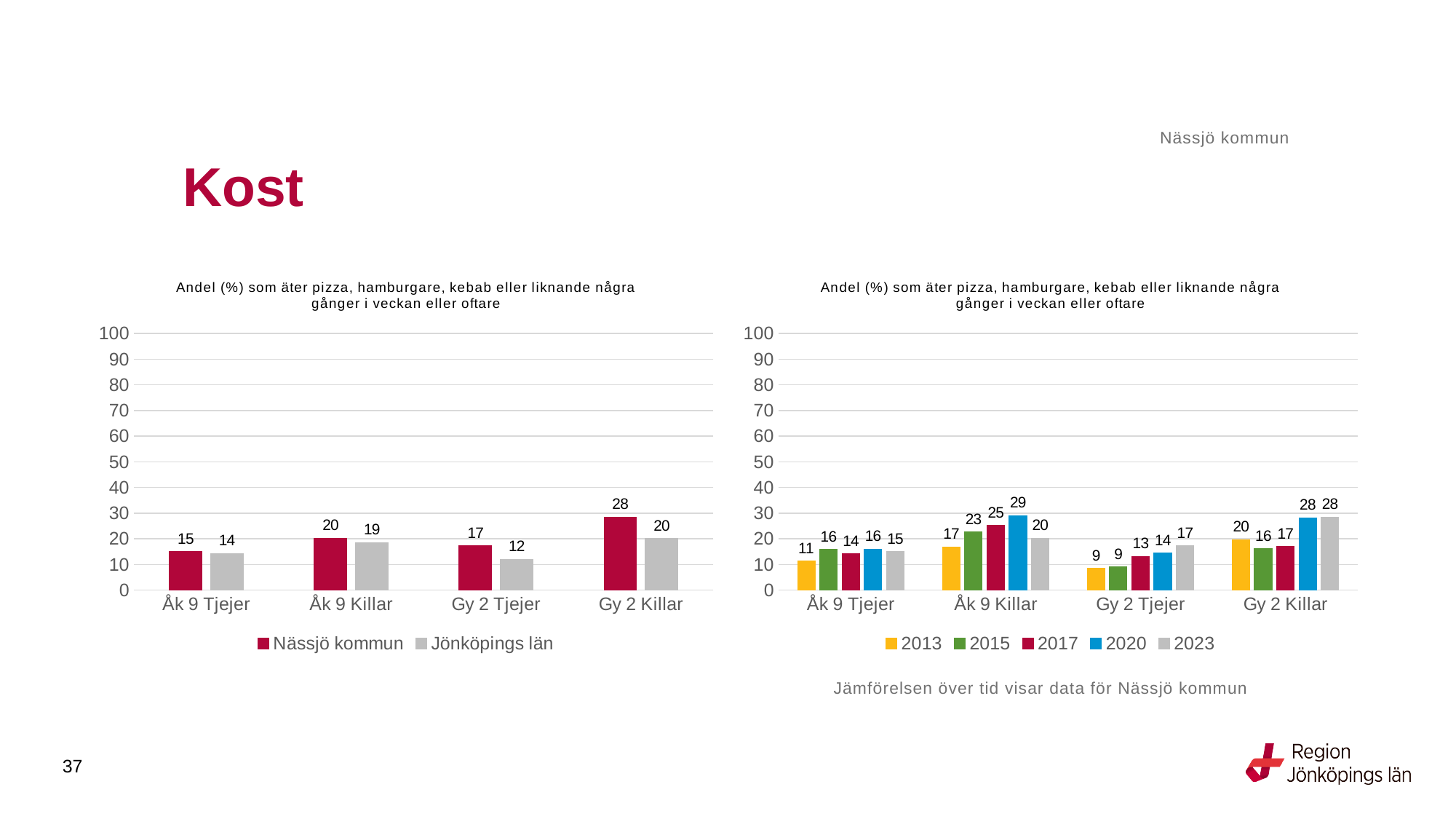
In the right chart, what is the value for 2013 for Gy 2 Tjejer? 9 In the left chart, what is the value for Jönköpings län for Gy 2 Tjejer? 12 In the left chart, what is the difference between Nässjö kommun and Jönköpings län for Gy 2 Killar? 8 In the right chart, what is the value for 2020 for Åk 9 Killar? 29 In the left chart, what is the value for Nässjö kommun for Gy 2 Killar? 28 In the right chart, is the value for 2017 for Åk 9 Killar larger or smaller than the value for 2023 for Åk 9 Killar? larger What kind of chart is the right chart? bar chart In the right chart, how many series does the legend list? 5 In the right chart, do the values for Gy 2 Tjejer rise or fall from 2013 to 2023? rise In the left chart, which category has the highest value for Nässjö kommun? Gy 2 Killar In the right chart, which category has the lowest value for 2013? Gy 2 Tjejer In the left chart, how many series does the legend list? 2